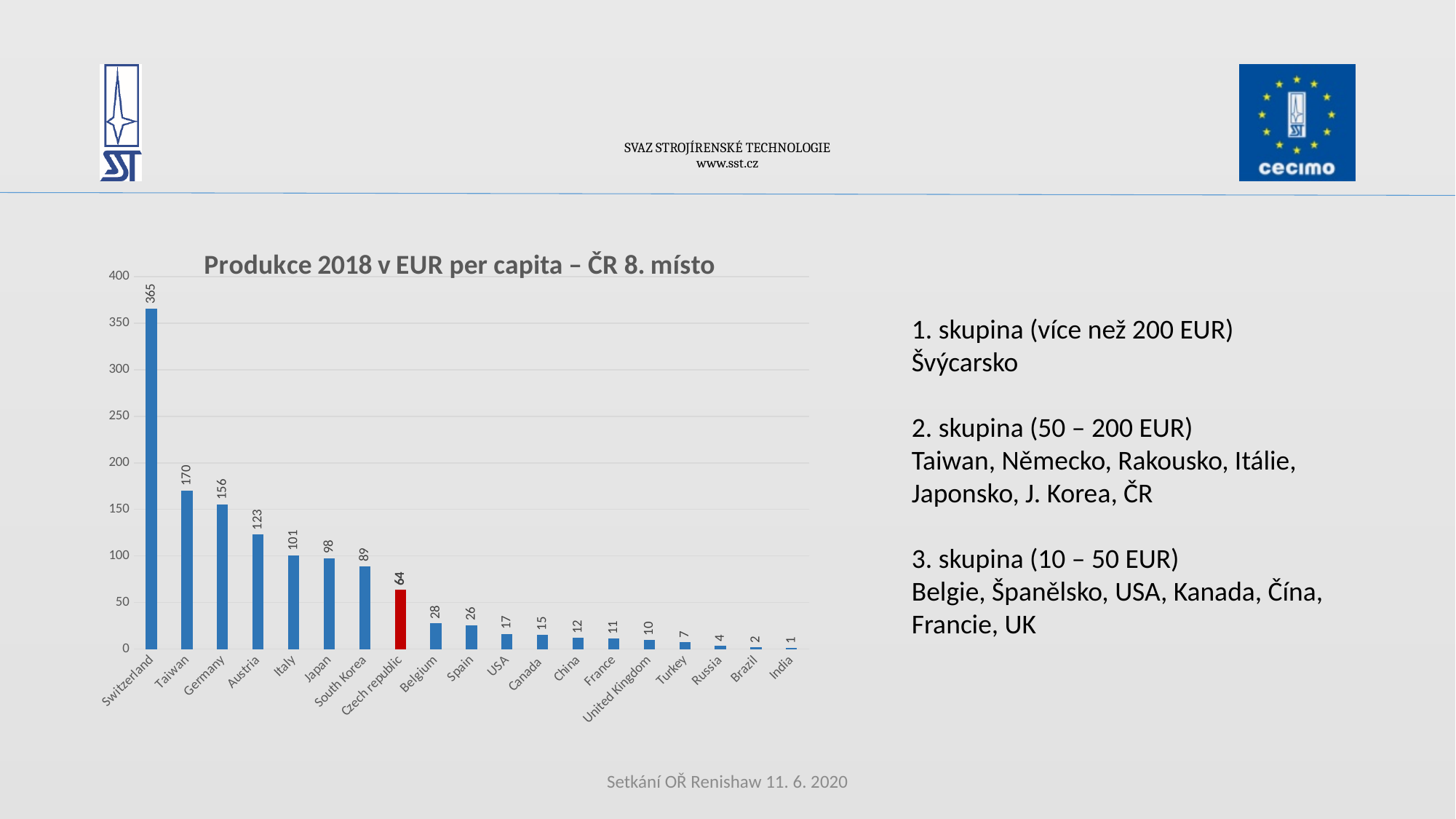
What is the value for Switzerland? 365 What is the value for Japan? 98 What kind of chart is shown on the slide? bar chart How many countries are shown on the chart? 19 Do the values rise or fall from left to right along the x axis? fall What is the difference between the values for Taiwan and Germany? 14 Is the value for South Korea greater or less than 100? less What is the value for the Czech republic? 64 Which country has the highest value? Switzerland Which country has the lowest value? India What is the title of the chart? Produkce 2018 v EUR per capita – ČR 8. místo Which is larger, the value for Austria or the value for Italy? Austria